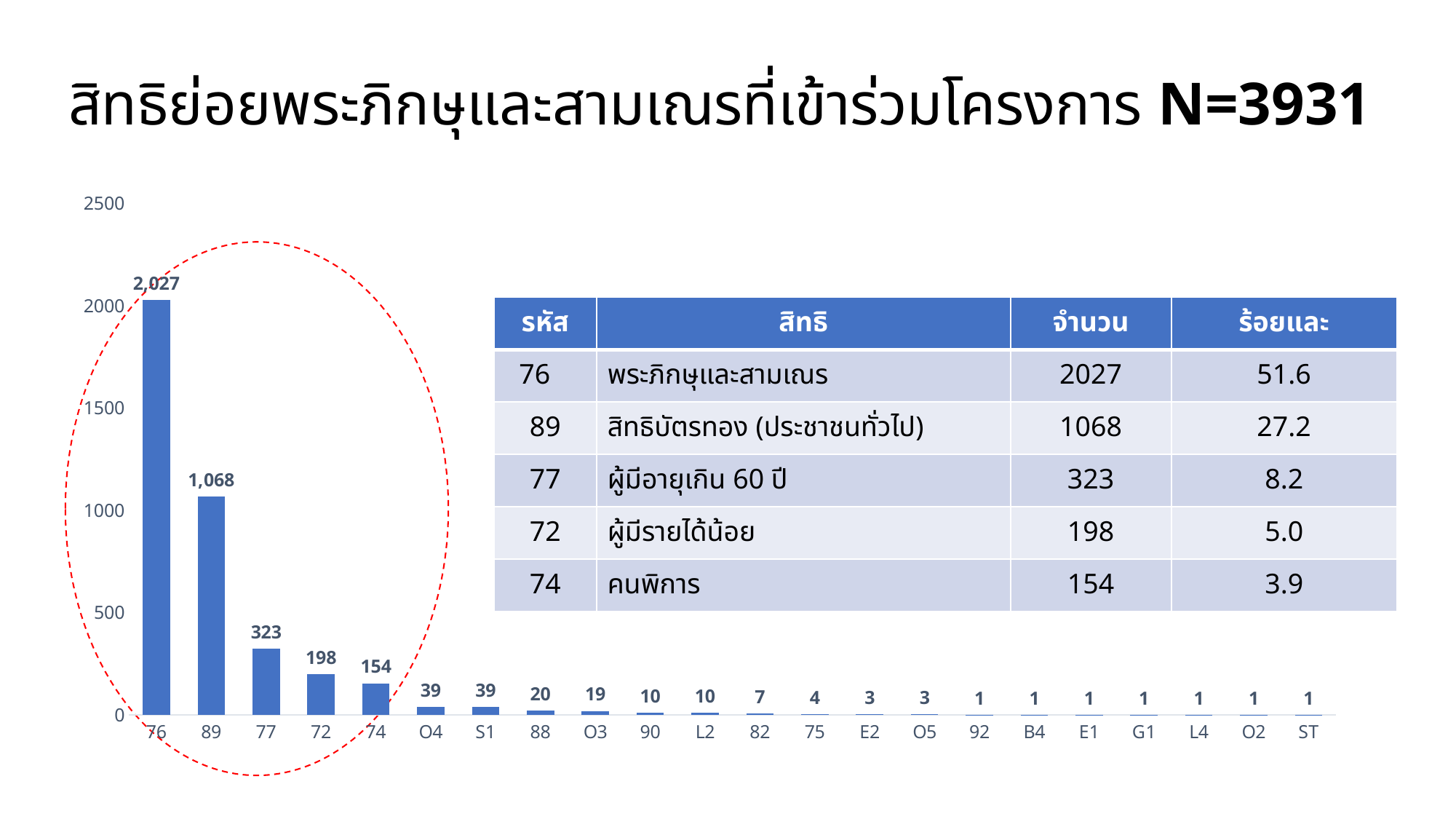
How many categories are shown on the x axis? 22 Is the value for category 77 greater or less than 500? less What is the value for category O4? 39 Which category has the highest value? 76 Which is larger, the value for 88 or the value for O3? 88 What kind of chart is shown on the slide? bar chart What is the value for category 89? 1,068 Do the values rise or fall from left to right along the x axis? fall What is the value for category 76? 2,027 What is the difference between the values for 76 and 89? 959 What is the value for category 72? 198 What is the difference between the values for 77 and 74? 169